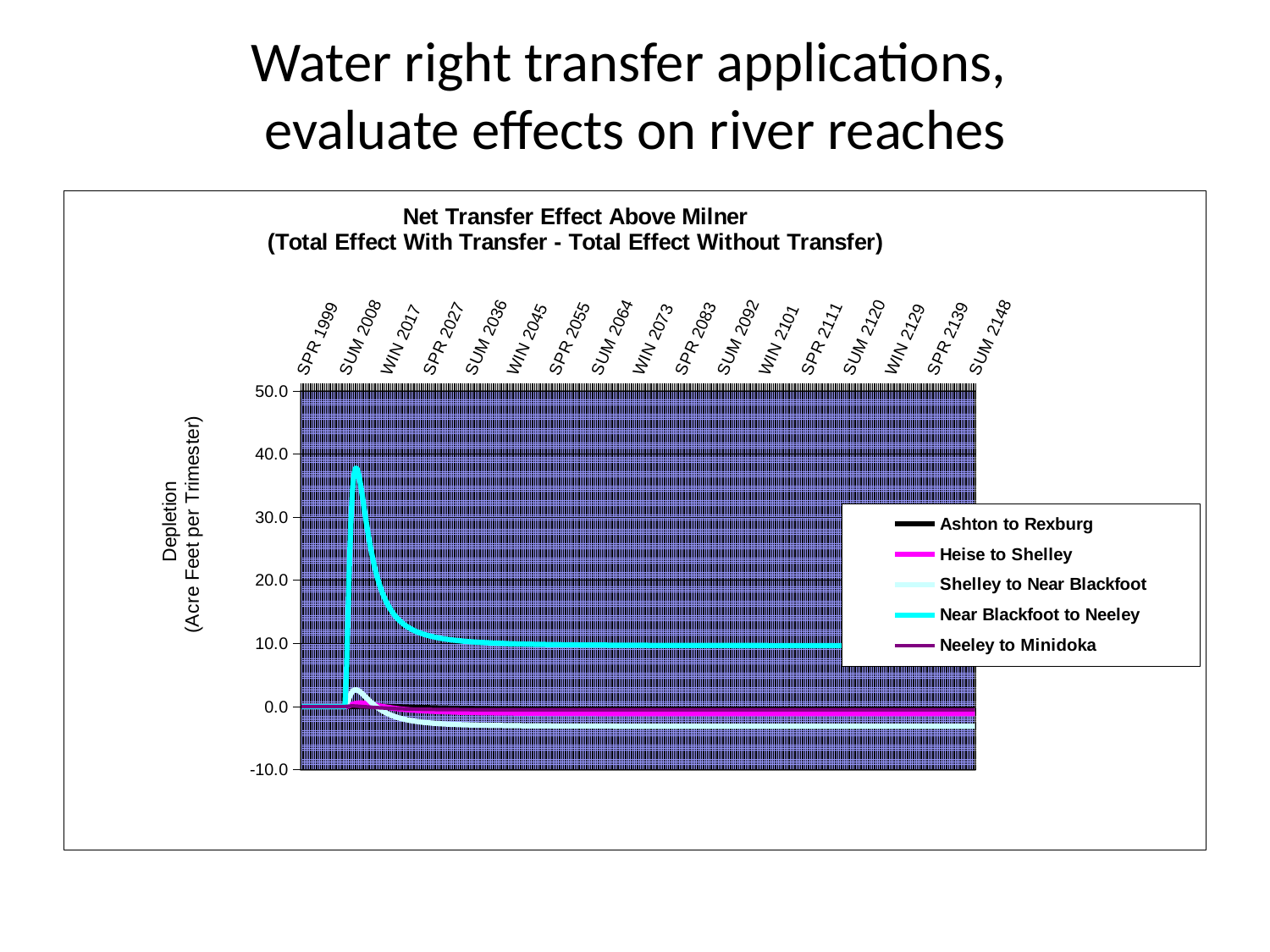
How many series does the legend list? 5 Is the peak value of the Near Blackfoot to Neeley series greater or less than 30.0? greater What kind of chart is shown on the slide? line chart What is the label of the vertical axis? Depletion (Acre Feet per Trimester) What is the title of the chart? Net Transfer Effect Above Milner (Total Effect With Transfer - Total Effect Without Transfer) What is the first label on the x axis? SPR 1999 Is the peak value of the Near Blackfoot to Neeley series greater or less than 40.0? less After its peak near SUM 2008, does the Near Blackfoot to Neeley series rise or fall along the x axis? fall At SUM 2148, which is larger: the Near Blackfoot to Neeley series or the Shelley to Near Blackfoot series? Near Blackfoot to Neeley Which series reaches the highest value on the chart? Near Blackfoot to Neeley Which series has the lowest values over most of the chart? Shelley to Near Blackfoot Is the long-run value of the Shelley to Near Blackfoot series greater or less than 0.0? less